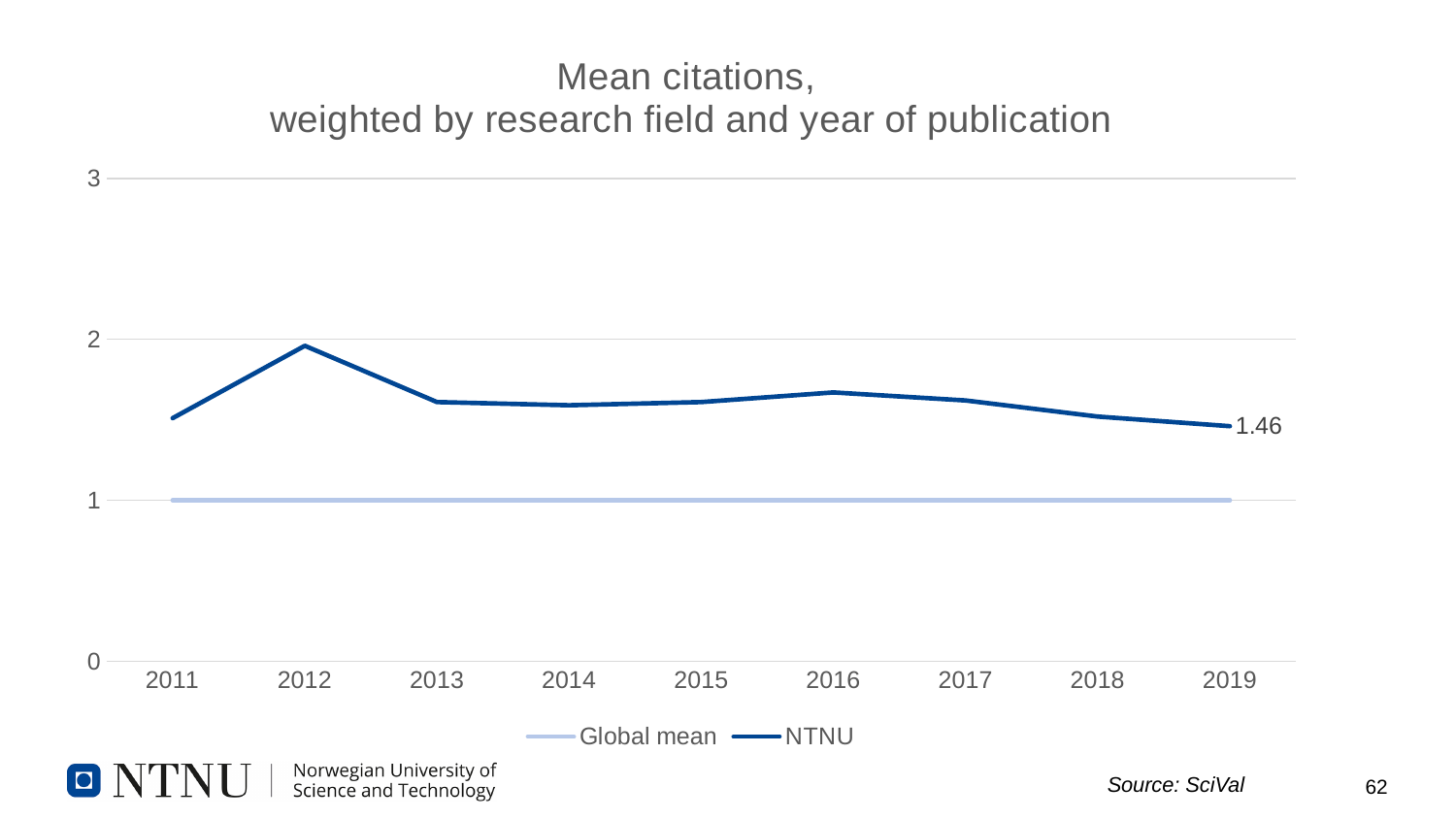
What is the NTNU value in 2019? 1.46 How many series does the legend list? 2 Which is larger, the NTNU value in 2012 or in 2013? 2012 Does the NTNU line rise or fall from 2016 to 2019? Fall Is the NTNU value for 2016 greater or less than 1? greater Is the NTNU value for 2013 greater or less than 2? less What value does the Global mean line sit at across all years? 1 How many years are shown on the x axis? 9 What source is cited for the chart? SciVal In which year is the NTNU value highest? 2012 What kind of chart is shown on the slide? Line chart In 2019, which series has the higher value, NTNU or Global mean? NTNU